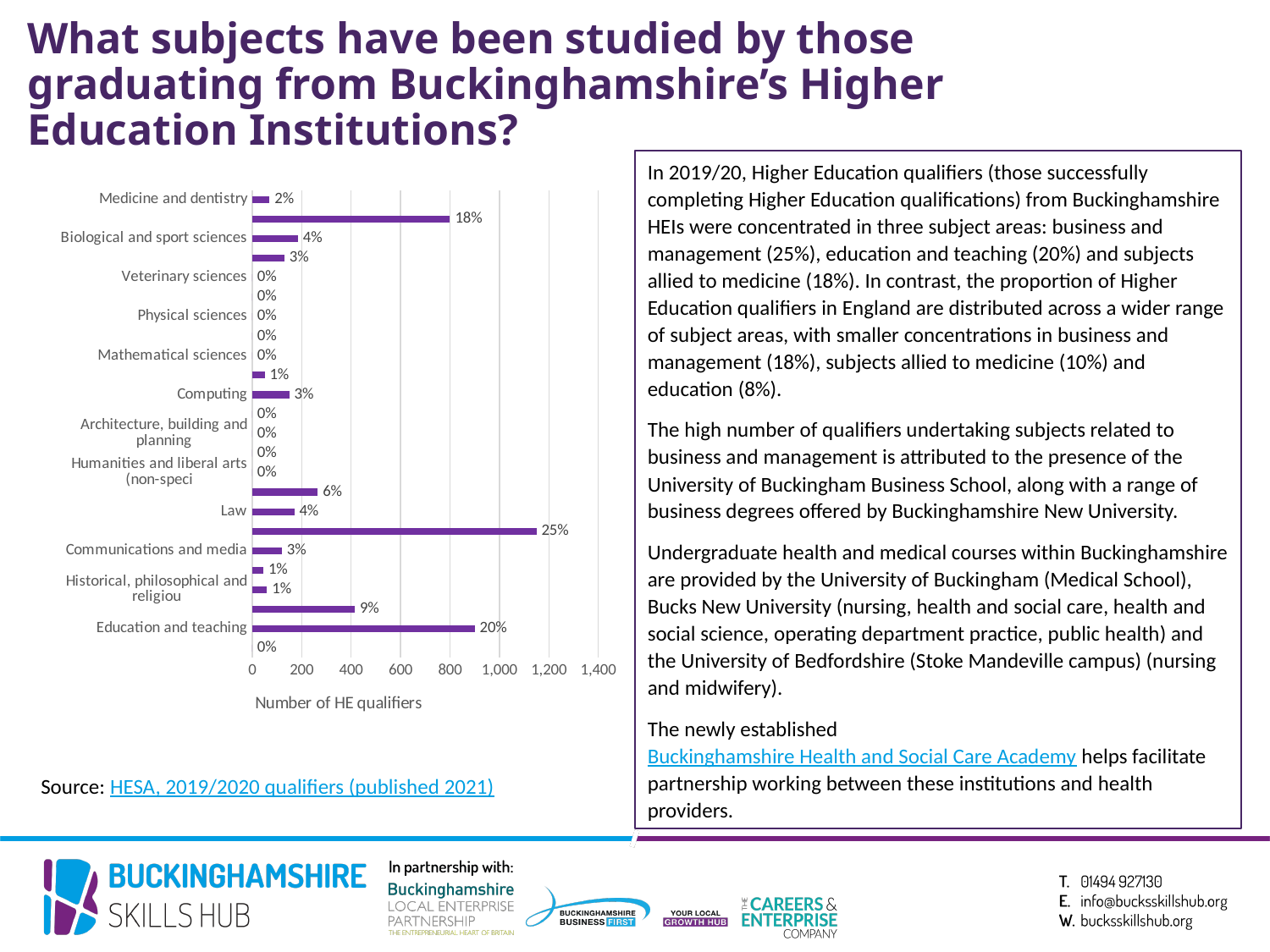
Is the number of HE qualifiers for Education and teaching greater or less than 800? greater Which has the larger value, Law or Computing? Law What is the difference between the data labels for Education and teaching and Medicine and dentistry? 18% What is the largest data label shown on the chart? 25% What is the data label for Law? 4% What kind of chart is shown on the slide? Bar chart What is the data label for Computing? 3% What is the data label for Communications and media? 3% What is the data label for Veterinary sciences? 0% What is the data label for Medicine and dentistry? 2% What is the title of the horizontal axis of the chart? Number of HE qualifiers What is the data label for Education and teaching? 20%